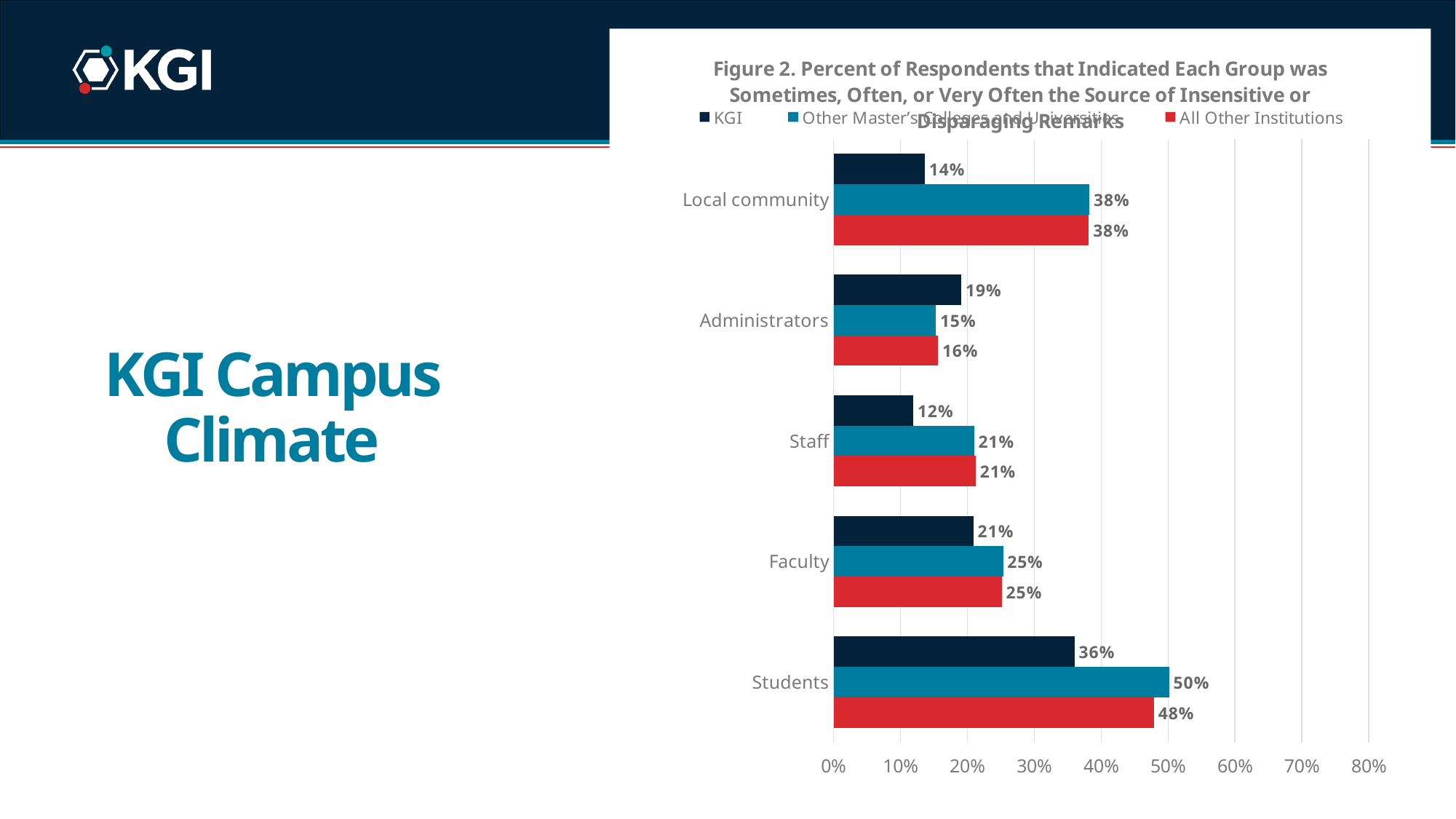
How many series does the legend list? 3 Which group has the lowest value in the KGI series? Staff How many groups are shown on the vertical axis of the chart? 5 What percent of KGI respondents indicated the local community was a source of insensitive or disparaging remarks? 14% For Administrators, which is larger: the KGI value or the All Other Institutions value? KGI What kind of chart is shown on the slide? bar chart Which group has the highest value in the KGI series? Students Which colour represents the All Other Institutions series? red What is the value for Administrators in the Other Master's Colleges and Universities series? 15% What is the difference between the Other Master's Colleges and Universities value and the KGI value for Students? 14% What is the value for Students in the All Other Institutions series? 48% Is the KGI value for Students greater or less than 40%? less